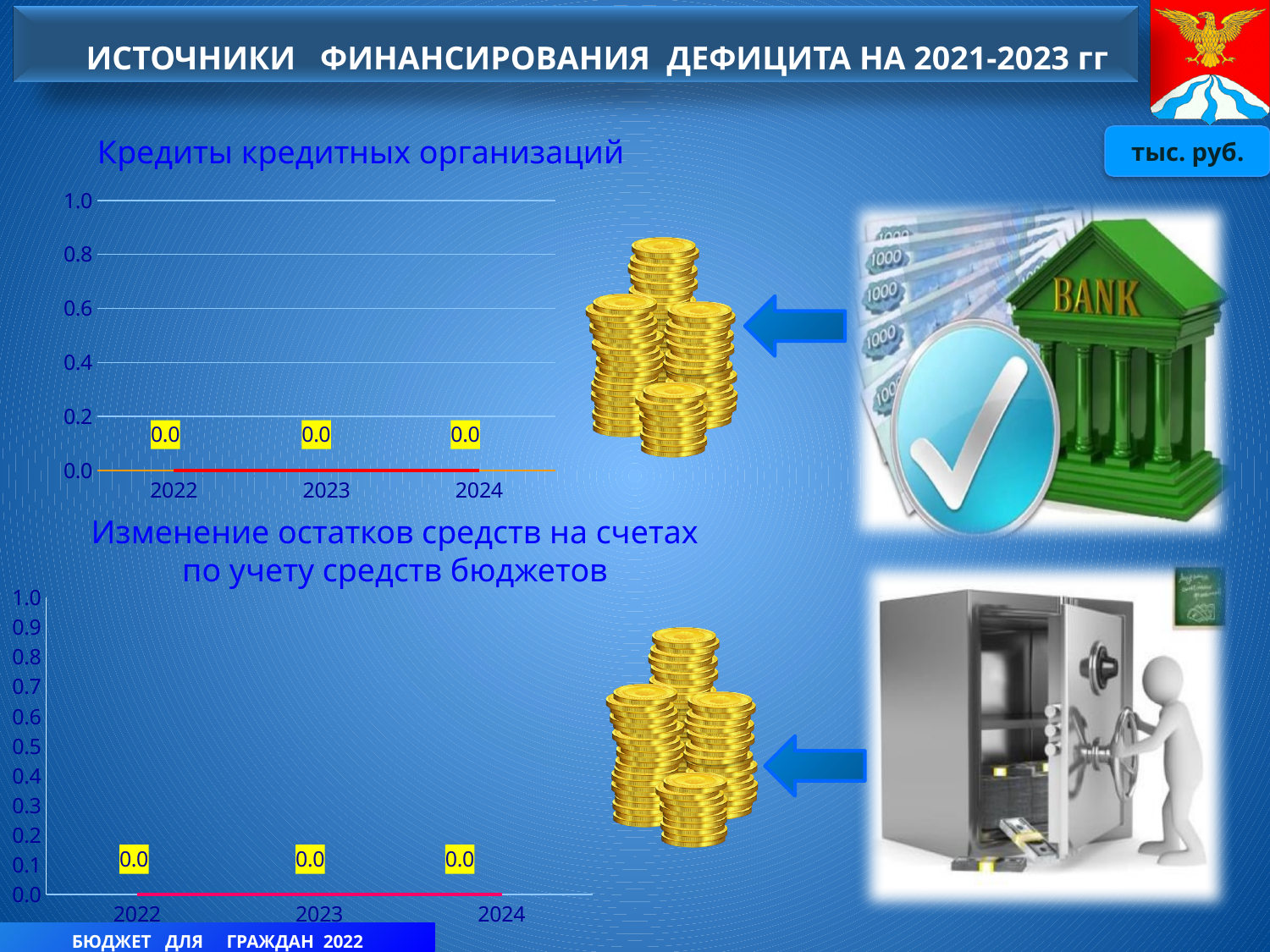
How many years are shown on the x axis of the chart titled 'Кредиты кредитных организаций'? 3 In the chart titled 'Изменение остатков средств на счетах по учету средств бюджетов', what is the value for 2023? 0.0 In the chart titled 'Кредиты кредитных организаций', what is the value for 2024? 0.0 In the chart titled 'Кредиты кредитных организаций', what is the difference between the values for 2023 and 2022? 0.0 In the chart titled 'Кредиты кредитных организаций', what is the value for 2022? 0.0 In the chart titled 'Изменение остатков средств на счетах по учету средств бюджетов', is the value for 2022 greater or less than 0.5? less In the chart titled 'Изменение остатков средств на счетах по учету средств бюджетов', what is the value for 2024? 0.0 In the chart titled 'Кредиты кредитных организаций', is the value for 2023 greater or less than 0.2? less What is the highest value shown on the y axis of the chart titled 'Изменение остатков средств на счетах по учету средств бюджетов'? 1.0 Do the values in the chart titled 'Кредиты кредитных организаций' rise, fall, or stay the same from 2022 to 2024? stay the same What unit of measurement is indicated for the charts on the slide? тыс. руб. How many categories are plotted in the chart titled 'Изменение остатков средств на счетах по учету средств бюджетов'? 3